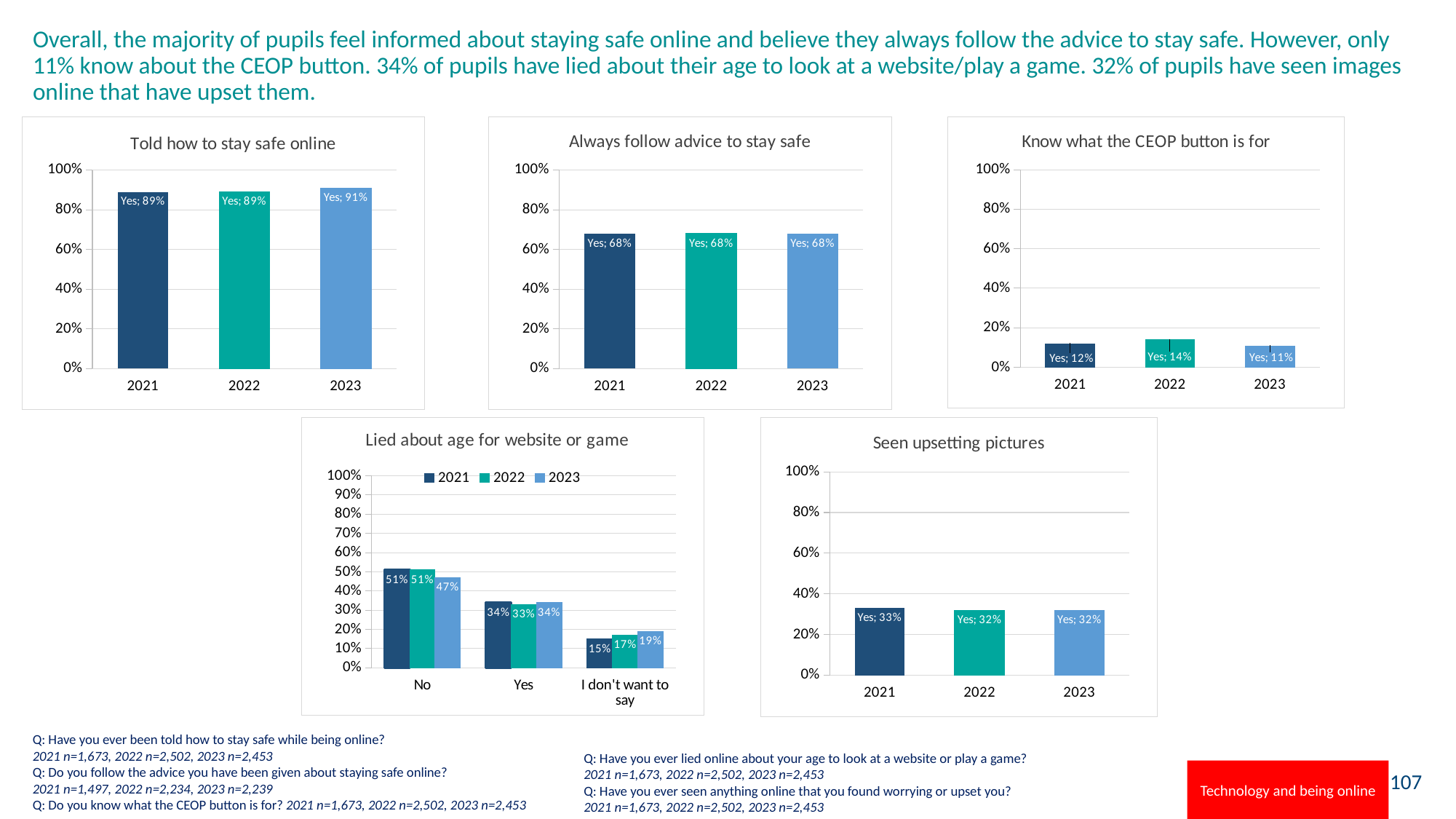
In the 'Told how to stay safe online' chart, what is the value for 2023? 91% In the 'Lied about age for website or game' chart, how many categories are shown on the x axis? 3 In the 'Know what the CEOP button is for' chart, is the value for 2021 greater or less than 20%? less In the 'Lied about age for website or game' chart, how many series does the legend list? 3 In the 'Seen upsetting pictures' chart, what is the value for 2021? 33% In the 'Always follow advice to stay safe' chart, what is the value for 2022? 68% What type of chart is 'Seen upsetting pictures'? Bar chart In the 'Know what the CEOP button is for' chart, which year has the lowest value? 2023 In the 'Lied about age for website or game' chart, which is larger for 2021: 'No' or 'Yes'? No In the 'Know what the CEOP button is for' chart, what is the difference between the 2022 and 2023 values? 3% In the 'Lied about age for website or game' chart, what is the 2023 value for 'No'? 47% In the 'Told how to stay safe online' chart, which year has the highest value? 2023